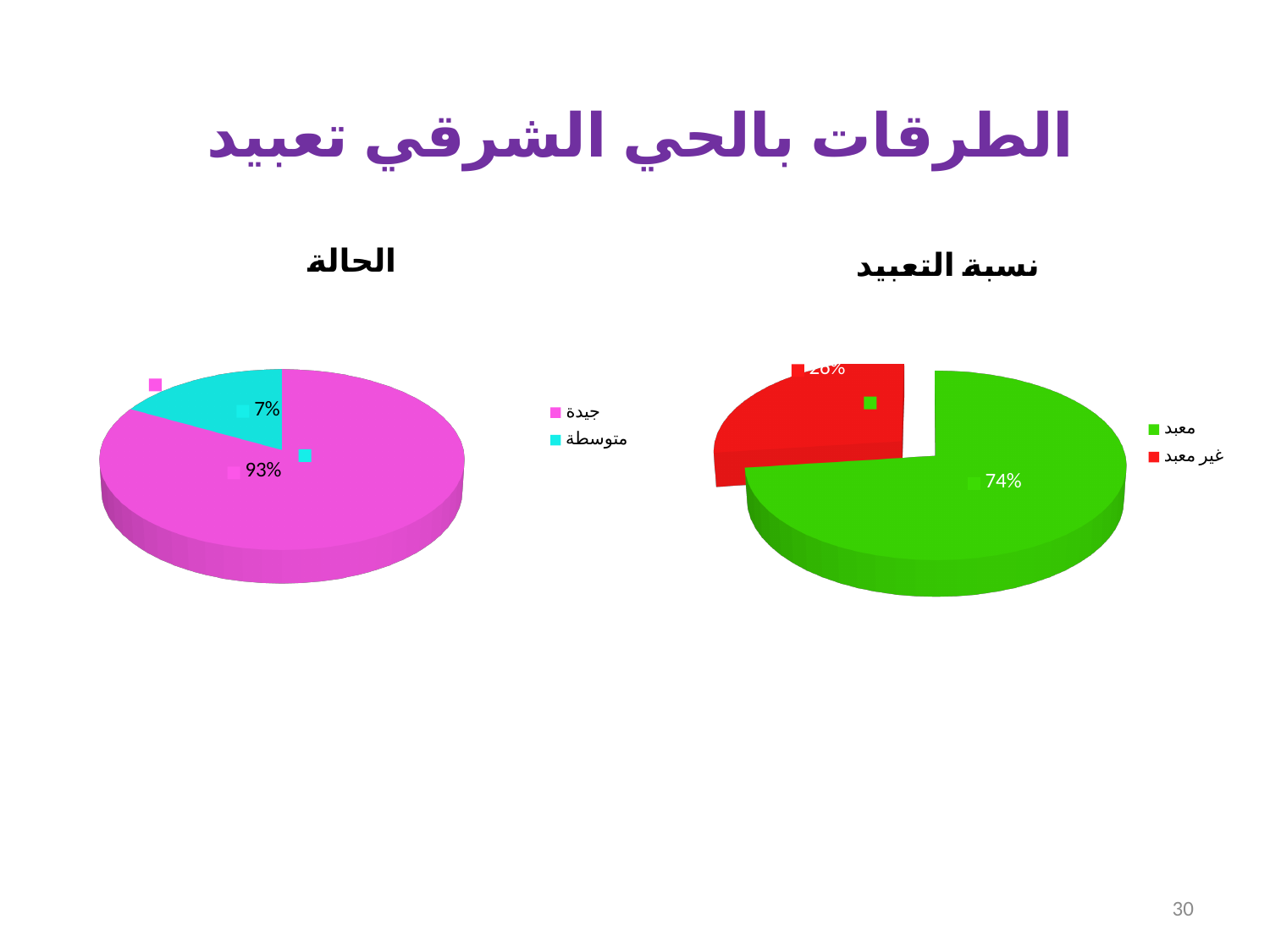
In the chart titled الحالة, what percentage is shown for متوسطة? 7% How many slices does the chart titled الحالة have? 2 How many categories does the legend of the chart titled نسبة التعبيد list? 2 What kind of chart is the chart titled الحالة? Pie chart In the chart titled الحالة, which category has the largest slice? جيدة In the chart titled الحالة, what is the difference in percentage points between جيدة and متوسطة? 86 In the chart titled الحالة, what percentage is shown for جيدة? 93% In the chart titled نسبة التعبيد, which is larger, معبد or غير معبد? معبد In the chart titled نسبة التعبيد, what colour is the slice for غير معبد? Red In the chart titled الحالة, which category has the smallest slice? متوسطة In the chart titled نسبة التعبيد, which category has the largest slice? معبد In the chart titled نسبة التعبيد, what percentage is shown for معبد? 74%